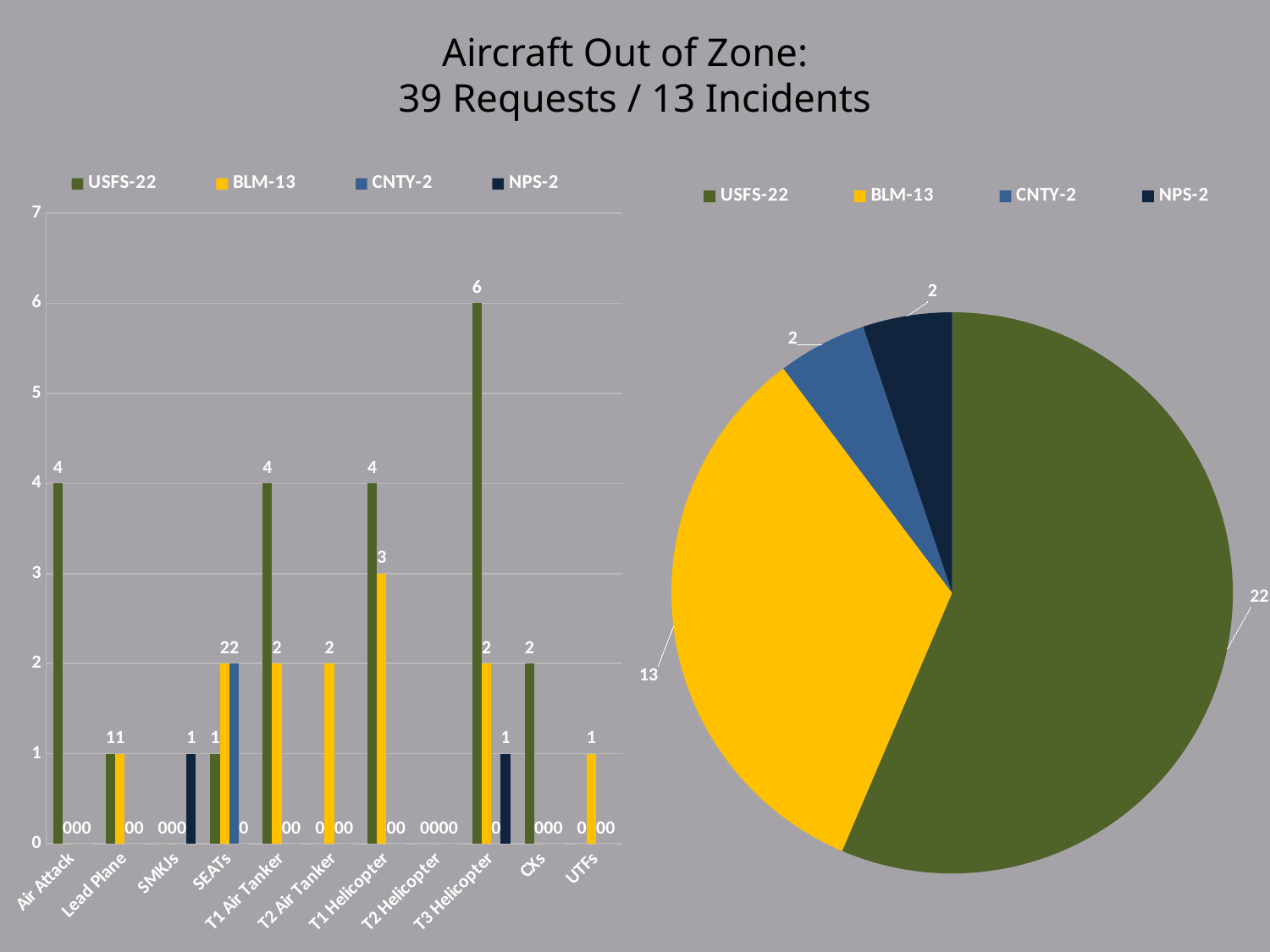
How many series does the legend of the bar chart list? 4 In the bar chart, which category has the highest USFS-22 value? T3 Helicopter In the bar chart, what is the USFS-22 value for T3 Helicopter? 6 What kind of chart is on the right side of the slide? pie chart In the bar chart, how many categories are shown on the x axis? 11 What kind of chart is on the left side of the slide? bar chart In the bar chart, which is larger for SEATs: the USFS-22 value or the BLM-13 value? BLM-13 What is the title of the slide's charts? Aircraft Out of Zone: 39 Requests / 13 Incidents In the pie chart, which slice is the largest? USFS-22 In the bar chart, what is the BLM-13 value for T1 Helicopter? 3 In the bar chart, what is the difference between the USFS-22 and BLM-13 values for T1 Air Tanker? 2 In the pie chart, what is the value of the USFS-22 slice? 22